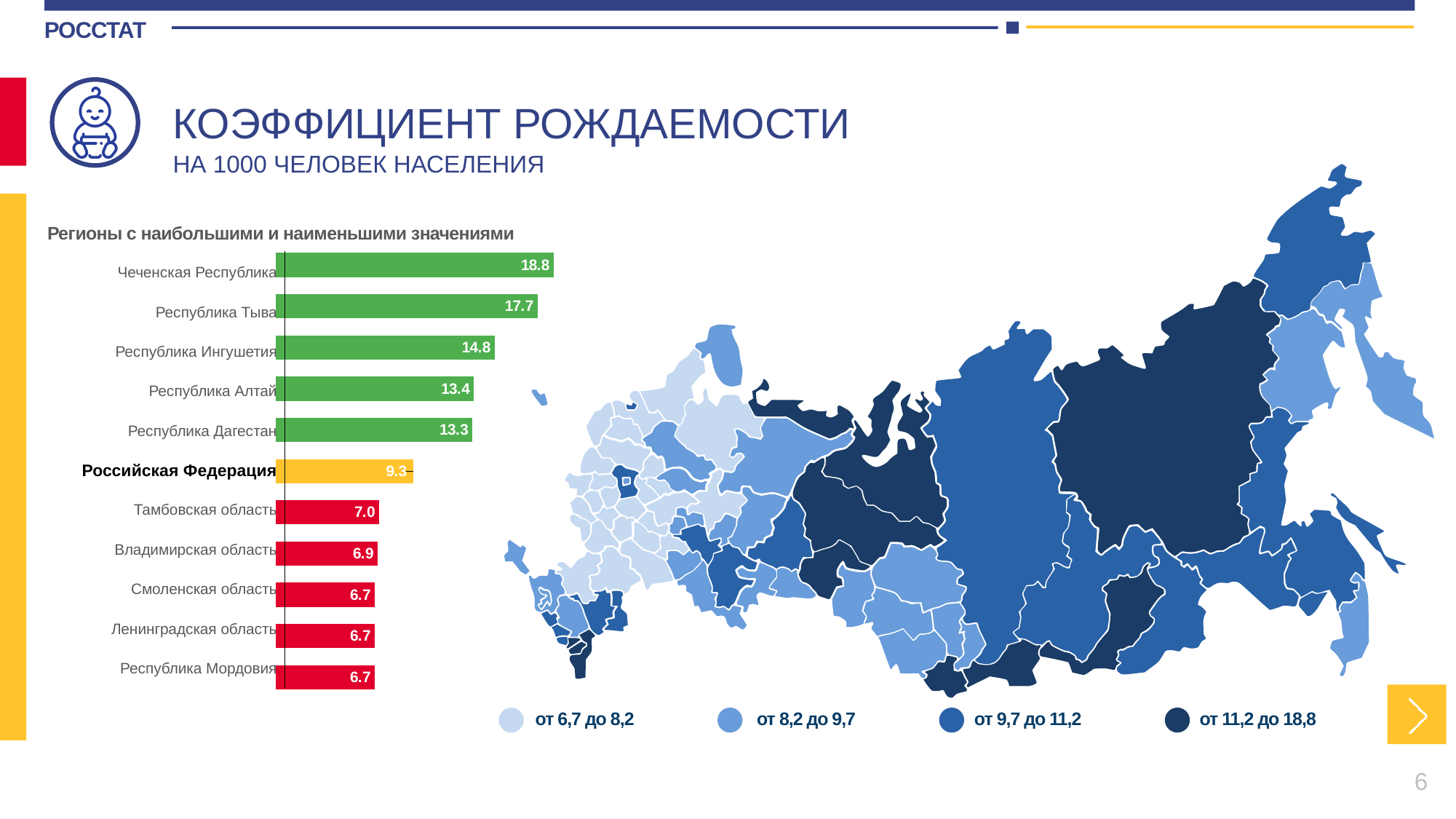
Which region has the highest value in the bar chart? Чеченская Республика Which has a larger value, Тамбовская область or Смоленская область? Тамбовская область What is the birth rate value shown for Чеченская Республика? 18.8 How many regions (bars) are shown in the bar chart? 11 What is the difference between the values for Чеченская Республика and Российская Федерация? 9.5 Which has a larger value, Республика Тыва or Республика Ингушетия? Республика Тыва What is the value for Республика Алтай? 13.4 What kind of chart is used to show the regions with the highest and lowest values? Bar chart How many value ranges does the map legend list? 4 What is the value shown for Владимирская область? 6.9 What value is shown for Российская Федерация in the bar chart? 9.3 What is the difference between the values for Чеченская Республика and Республика Тыва? 1.1